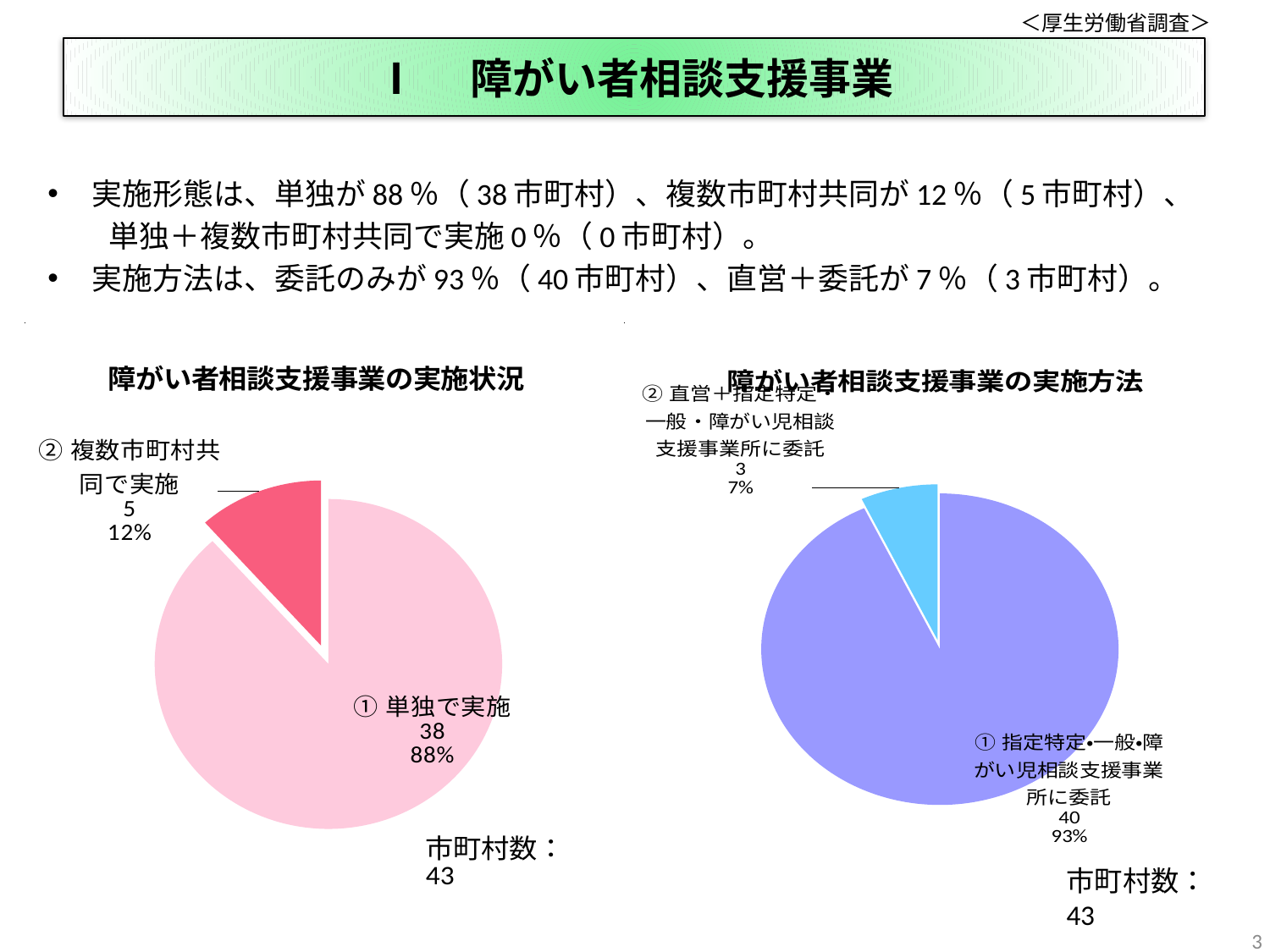
「障がい者相談支援事業の実施方法」のグラフで、最も小さい区分はどれですか？ ② 直営＋指定特定・一般・障がい児相談支援事業所に委託 「障がい者相談支援事業の実施状況」のグラフで、最も大きい区分はどれですか？ ① 単独で実施 「障がい者相談支援事業の実施状況」のグラフは何種類のグラフですか？ 円グラフ 「障がい者相談支援事業の実施方法」のグラフで、「② 直営＋指定特定・一般・障がい児相談支援事業所に委託」の割合は何％ですか？ 7% 「障がい者相談支援事業の実施状況」のグラフには区分がいくつありますか？ 2 「障がい者相談支援事業の実施方法」のグラフの市町村数の合計はいくつですか？ 43 「障がい者相談支援事業の実施方法」のグラフで、「① 指定特定・一般・障がい児相談支援事業所に委託」の区分は何色ですか？ 紫（青紫） 「障がい者相談支援事業の実施状況」のグラフで、「① 単独で実施」と「② 複数市町村共同で実施」の市町村数の差はいくつですか？ 33 「障がい者相談支援事業の実施方法」のグラフで、「① 指定特定・一般・障がい児相談支援事業所に委託」の市町村数はいくつですか？ 40 「障がい者相談支援事業の実施方法」のグラフで、「① 指定特定・一般・障がい児相談支援事業所に委託」と「② 直営＋指定特定・一般・障がい児相談支援事業所に委託」の市町村数の差はいくつですか？ 37 「障がい者相談支援事業の実施状況」のグラフで、「② 複数市町村共同で実施」の割合は何％ですか？ 12% 「障がい者相談支援事業の実施状況」のグラフで、「① 単独で実施」の市町村数はいくつですか？ 38